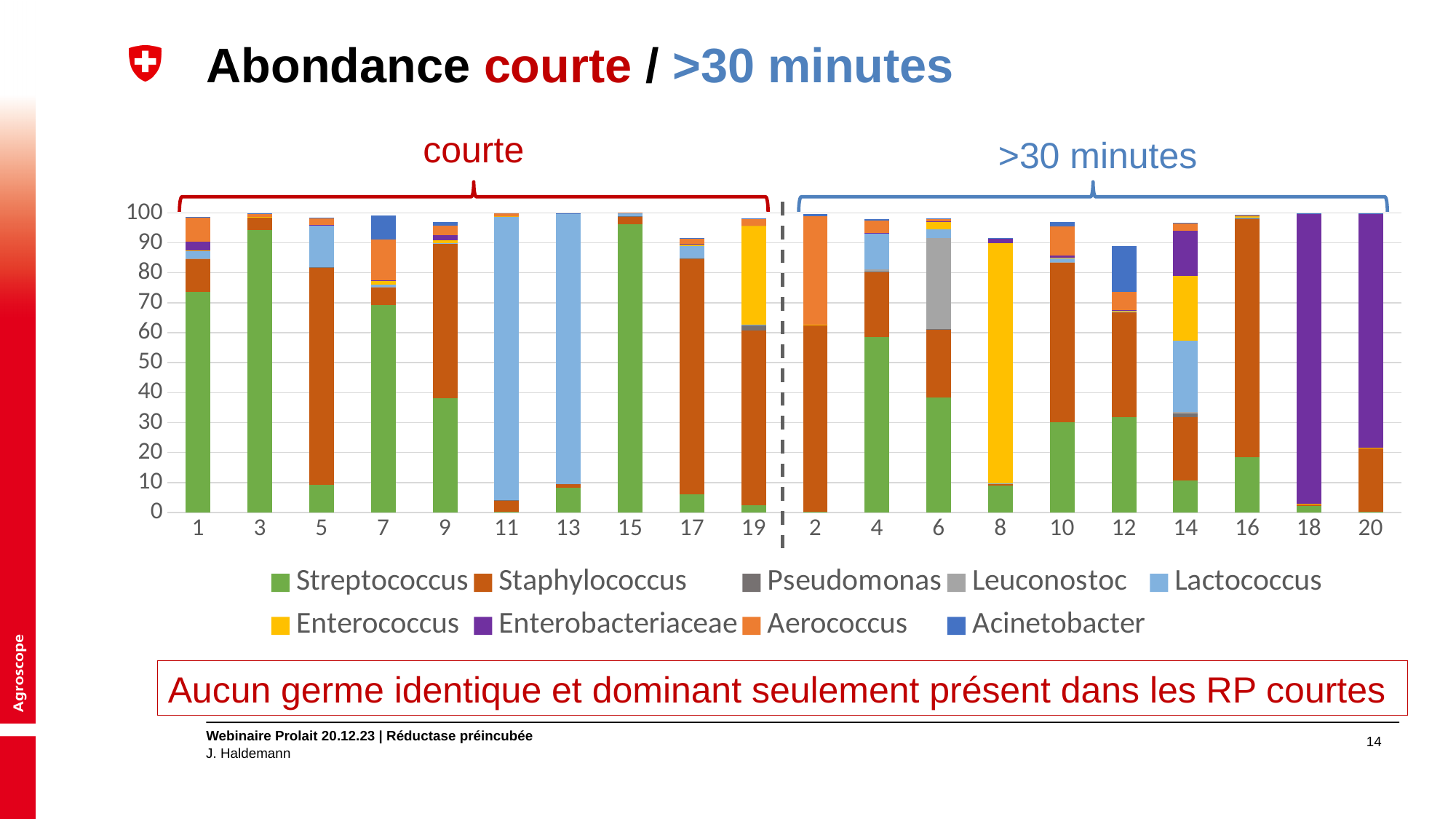
Which sample has the larger Streptococcus value, sample 3 or sample 9? Sample 3 How many bars (samples) are plotted on the x axis? 20 How many series does the legend list? 9 Which series is shown in purple in the legend? Enterobacteriaceae What kind of chart is shown on the slide? Stacked bar chart Which sample has the larger Enterobacteriaceae value, sample 18 or sample 20? Sample 18 Is the Streptococcus value for sample 9 greater or less than 40? less Is the Streptococcus value for sample 14 greater or less than 20? less Is the Enterococcus value for sample 8 greater or less than 70? greater Which colour represents Streptococcus in the legend? Green